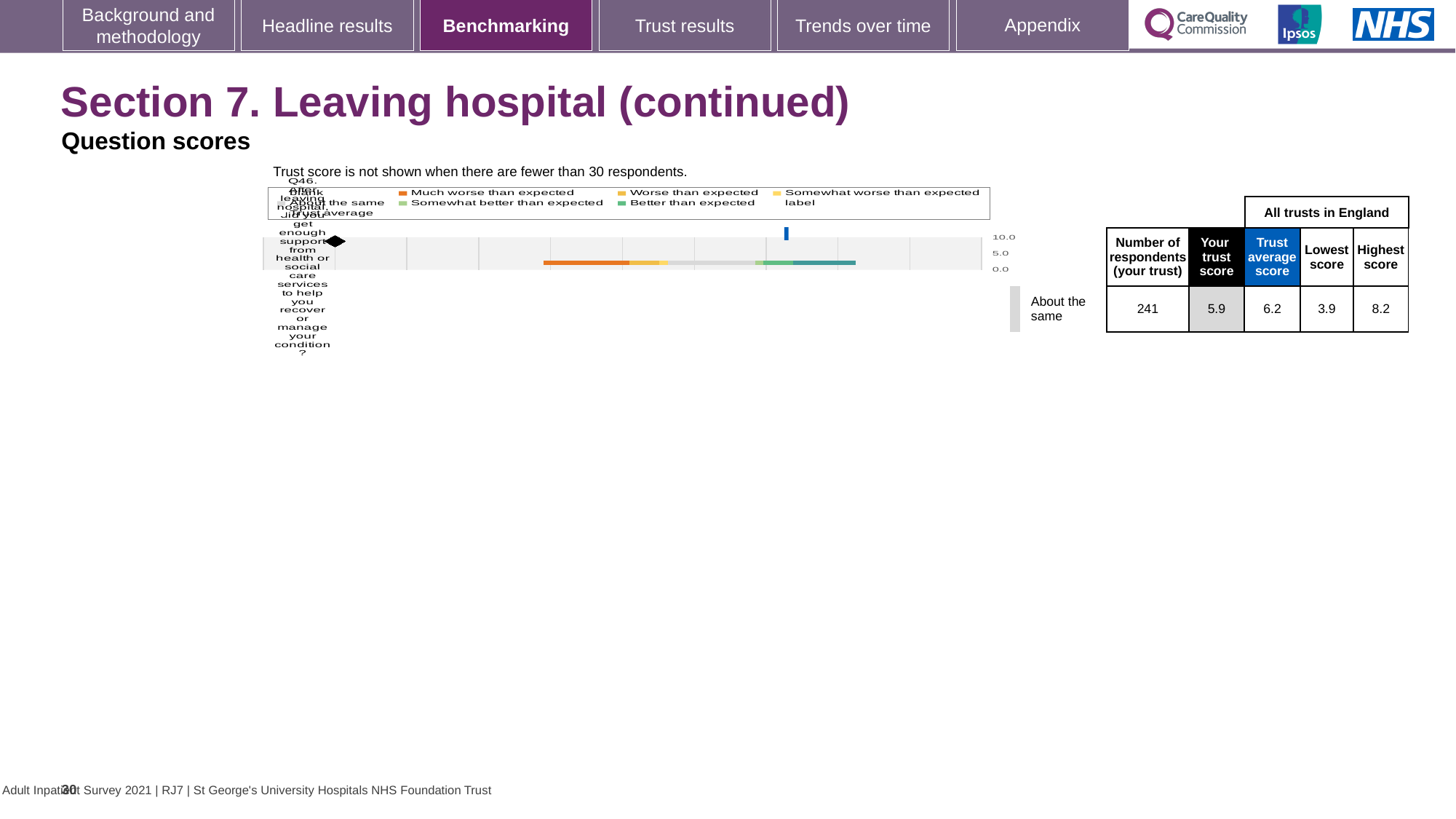
Which legend entry is shown in orange in the chart legend? Much worse than expected Which is larger for Q46: your trust score or the trust average score? Trust average score What kind of chart is shown on the slide for Q46? bar chart What is the highest score among all trusts in England for Q46? 8.2 What is the highest tick value shown on the chart's score axis? 10.0 Is your trust score for Q46 greater or less than 5.0? greater What is the number of respondents (your trust) for Q46? 241 What is the lowest score among all trusts in England for Q46? 3.9 How many questions are plotted in the chart? 1 What is the difference between the highest score and the lowest score for Q46? 4.3 What is the trust average score for Q46? 6.2 What is your trust score for Q46? 5.9